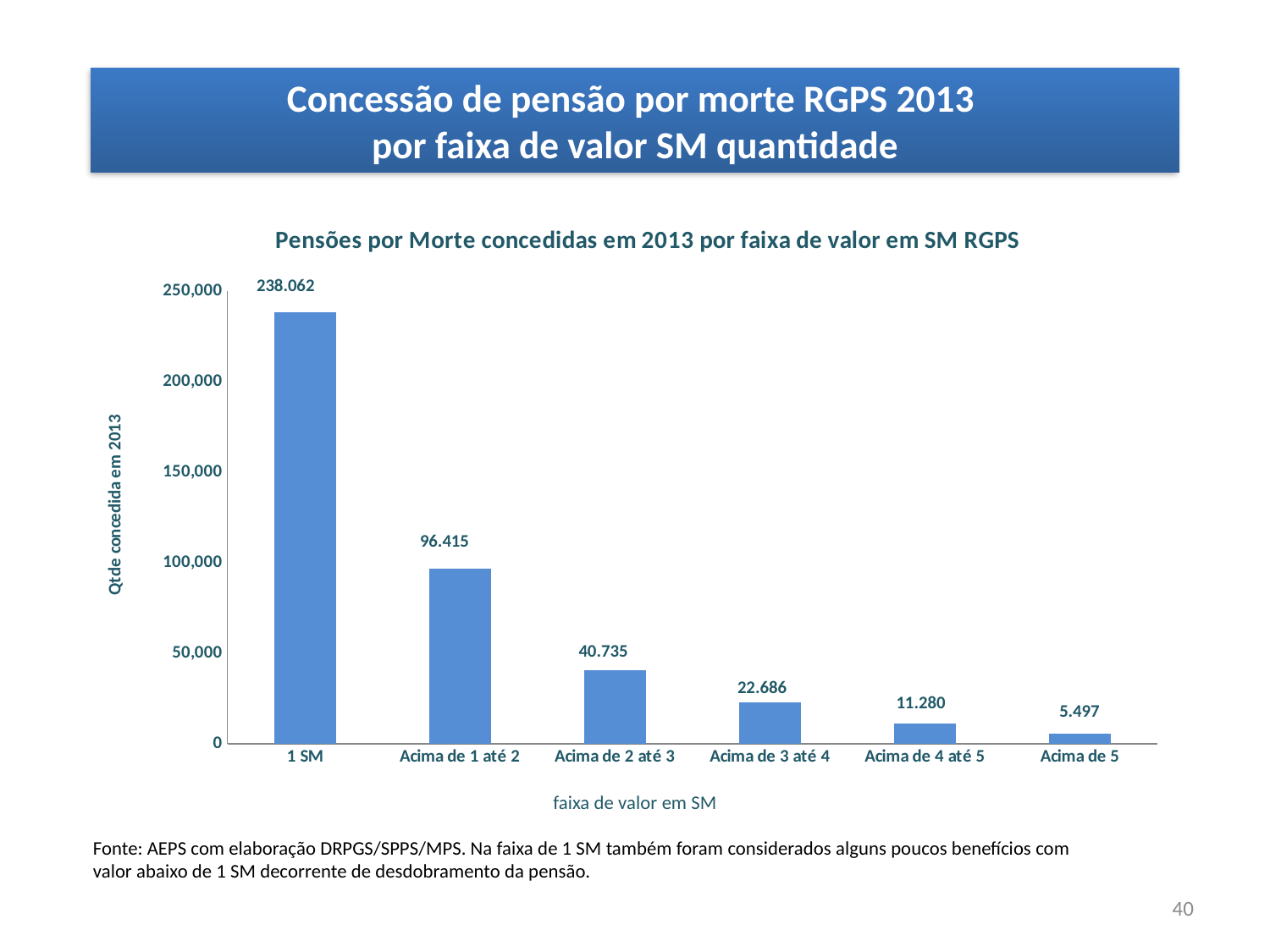
What kind of chart is shown on the slide? Bar chart Do the values rise or fall moving from left to right along the x axis? Fall Which is larger, the value for Acima de 4 até 5 or the value for Acima de 5? Acima de 4 até 5 Which category has the lowest value? Acima de 5 What is the value for the Acima de 3 até 4 category? 22.686 Which category has the highest value? 1 SM What is the value for the 1 SM category? 238.062 How many categories are shown on the x axis? 6 What is the value for the Acima de 1 até 2 category? 96.415 What is the difference between the values for Acima de 2 até 3 and Acima de 3 até 4? 18.049 What is the difference between the values for 1 SM and Acima de 1 até 2? 141.647 What is the value for the Acima de 5 category? 5.497